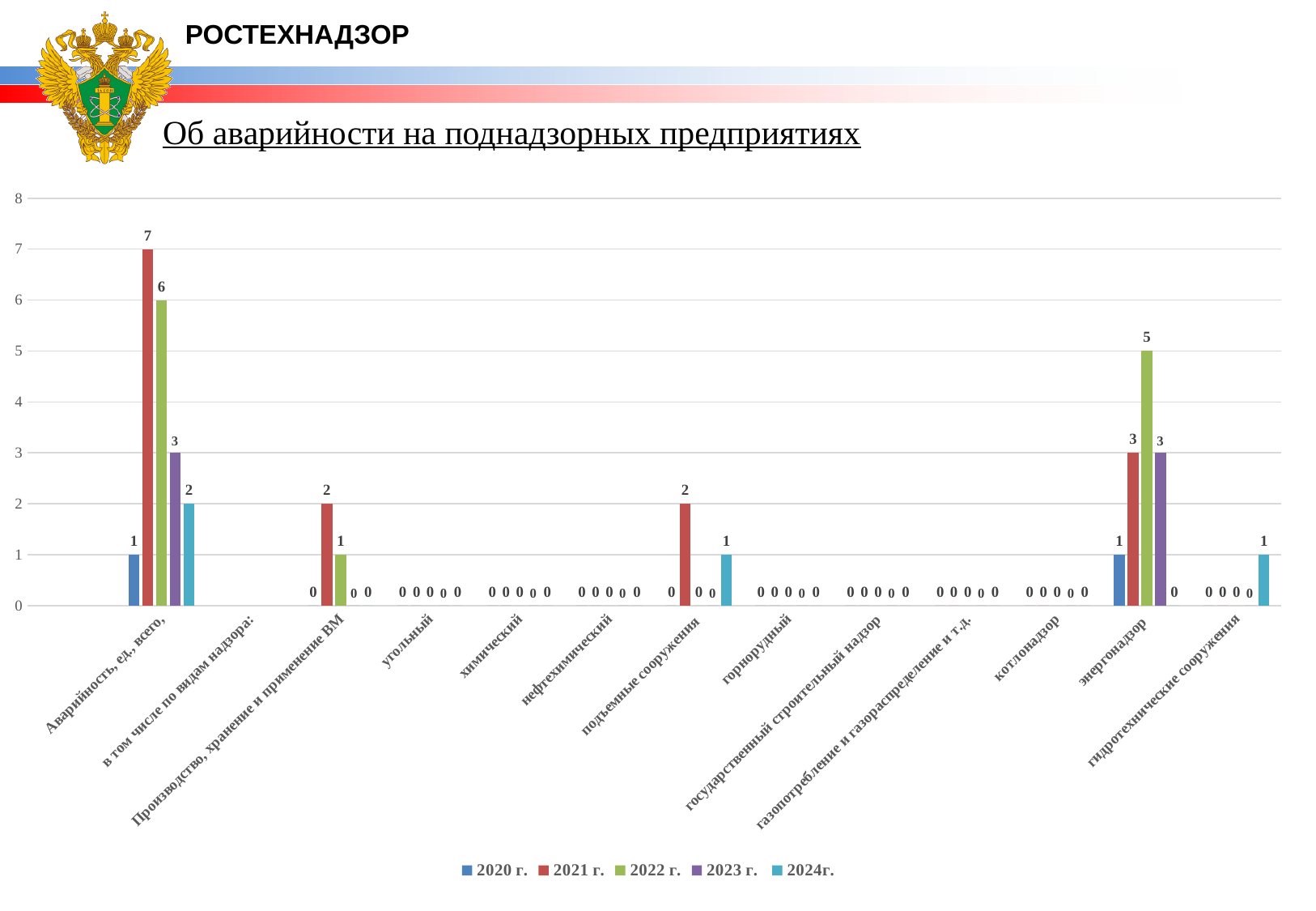
What is the value for 2021 г. in the category "Производство, хранение и применение ВМ"? 2 What is the difference between the 2021 г. and 2023 г. values in the category "Аварийность, ед., всего"? 4 What is the value for 2024г. in the category "гидротехнические сооружения"? 1 Which year has the highest value in the category "Аварийность, ед., всего"? 2021 г. What kind of chart is shown on the slide? bar chart What is the value for 2021 г. in the category "Аварийность, ед., всего"? 7 Which year has the lowest value in the category "Аварийность, ед., всего"? 2020 г. What is the value for 2024г. in the category "подъемные сооружения"? 1 What is the value for 2022 г. in the category "энергонадзор"? 5 What is the title of the chart on the slide? Об аварийности на поднадзорных предприятиях In the category "энергонадзор", which is larger: the value for 2022 г. or the value for 2021 г.? 2022 г. How many series does the legend list? 5